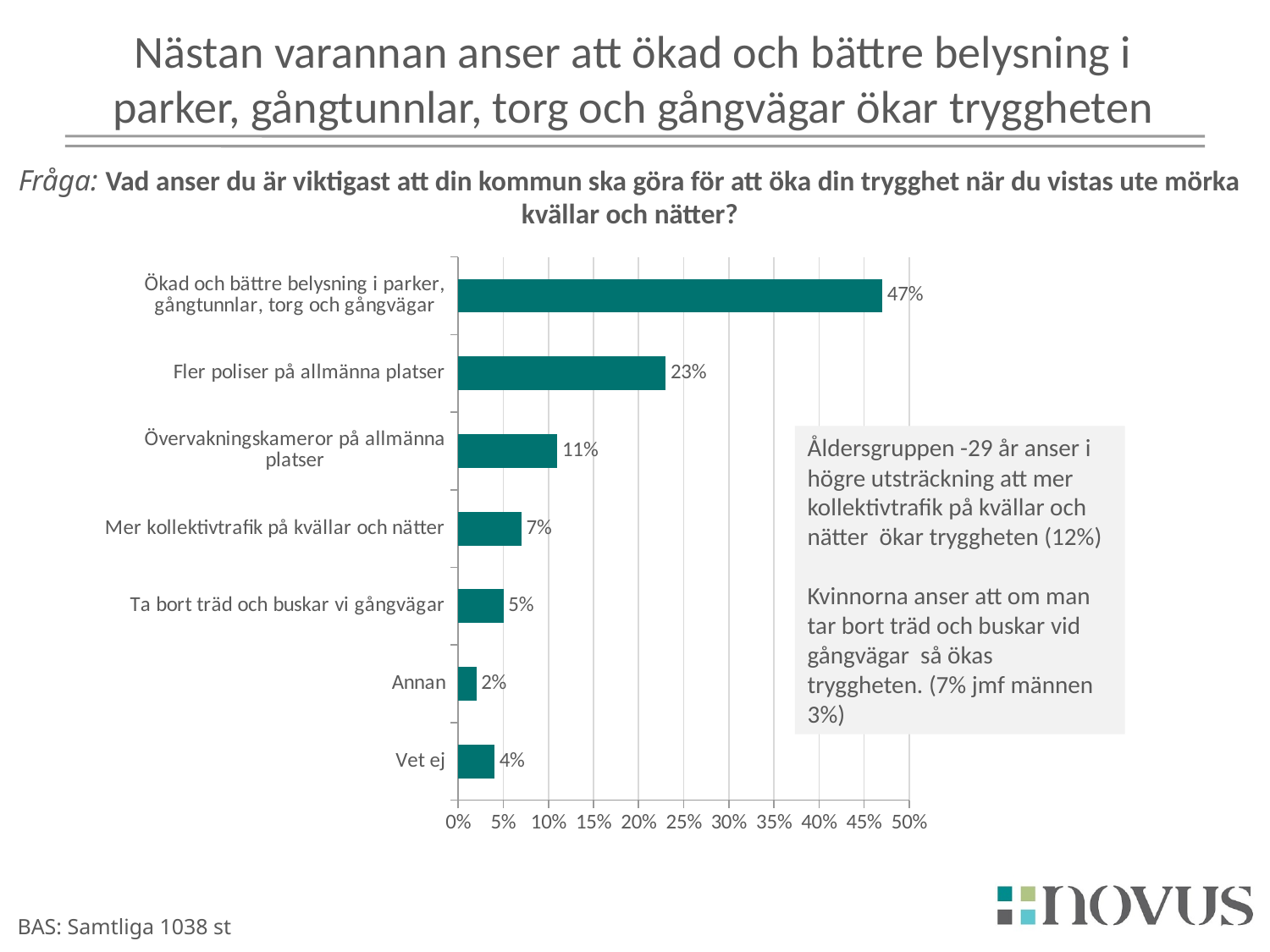
Which is larger, the value for "Mer kollektivtrafik på kvällar och nätter" or the value for "Ta bort träd och buskar vi gångvägar"? Mer kollektivtrafik på kvällar och nätter What is the highest tick value shown on the horizontal axis? 50% What is the value for "Vet ej"? 4% What is the value for "Övervakningskameror på allmänna platser"? 11% Which category has the lowest value? Annan How many categories are shown in the chart? 7 What kind of chart is shown on the slide? Bar chart What is the difference between the values for "Ta bort träd och buskar vi gångvägar" and "Annan"? 3% What is the difference between the values for "Ökad och bättre belysning i parker, gångtunnlar, torg och gångvägar" and "Fler poliser på allmänna platser"? 24% Which category has the highest value? Ökad och bättre belysning i parker, gångtunnlar, torg och gångvägar Is the value for "Fler poliser på allmänna platser" greater or less than 20%? greater What is the value for "Fler poliser på allmänna platser"? 23%